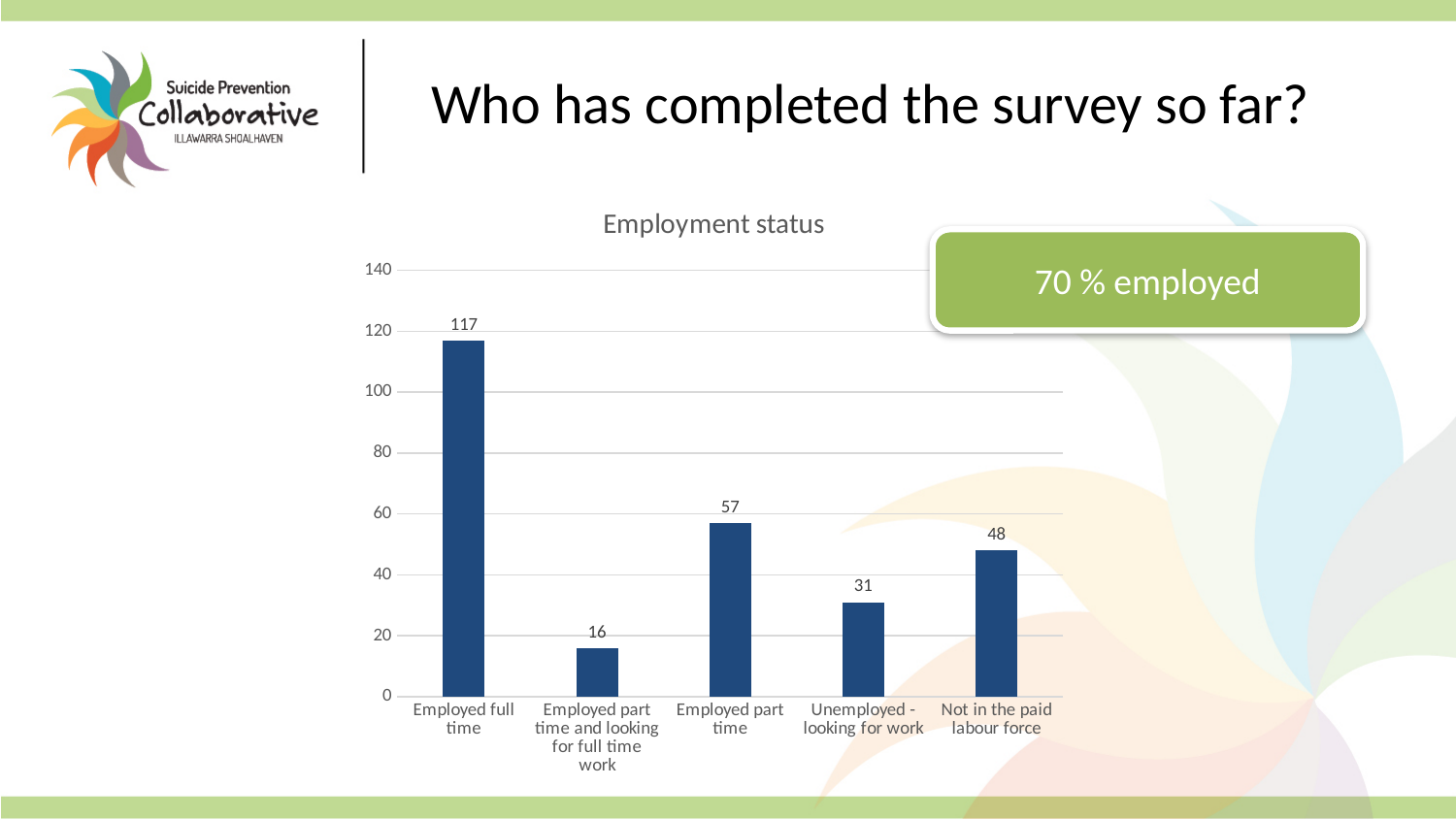
What kind of chart is shown on the slide? bar chart Which is larger, Not in the paid labour force or Unemployed - looking for work? Not in the paid labour force Is the value for Employed part time greater or less than 40? greater What is the title of the chart? Employment status What is the difference between Employed full time and Employed part time? 60 What is the value for Unemployed - looking for work? 31 What is the value for Employed full time? 117 Which employment status category has the highest value? Employed full time What is the value for Not in the paid labour force? 48 How many categories are shown on the x axis? 5 Which employment status category has the lowest value? Employed part time and looking for full time work What percentage is stated as employed in the green box next to the chart? 70 %